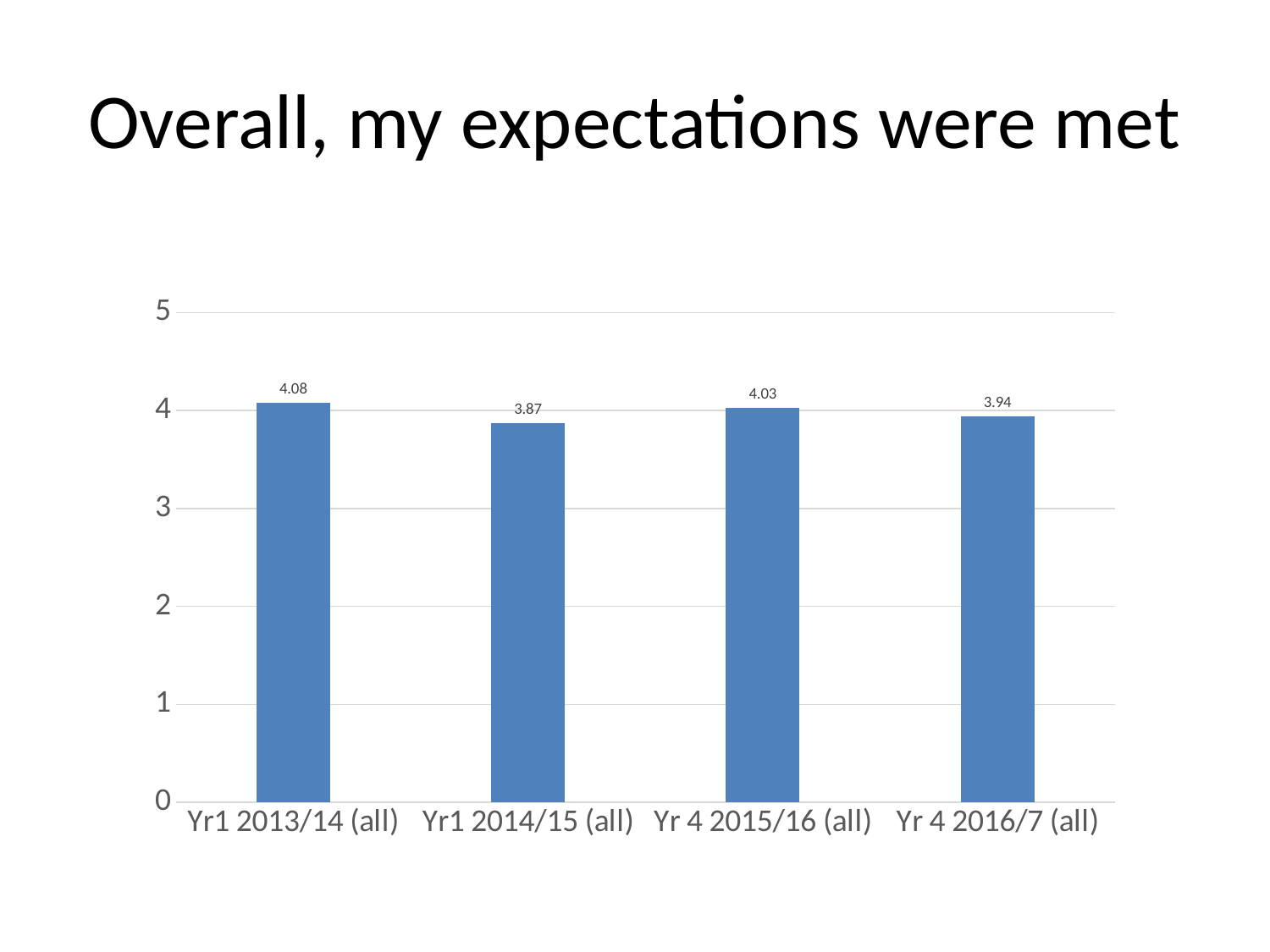
Which is larger, the value for Yr 4 2015/16 (all) or Yr 4 2016/7 (all)? Yr 4 2015/16 (all) What is the value for Yr1 2014/15 (all)? 3.87 What is the difference between the values for Yr1 2013/14 (all) and Yr1 2014/15 (all)? 0.21 Which category has the lowest value? Yr1 2014/15 (all) Is the value for Yr1 2014/15 (all) greater or less than 4? less What is the title of the slide? Overall, my expectations were met What kind of chart is shown on the slide? bar chart Which category has the highest value? Yr1 2013/14 (all) What is the value for Yr 4 2015/16 (all)? 4.03 What is the value for Yr1 2013/14 (all)? 4.08 What is the value for Yr 4 2016/7 (all)? 3.94 How many categories are shown on the x axis? 4